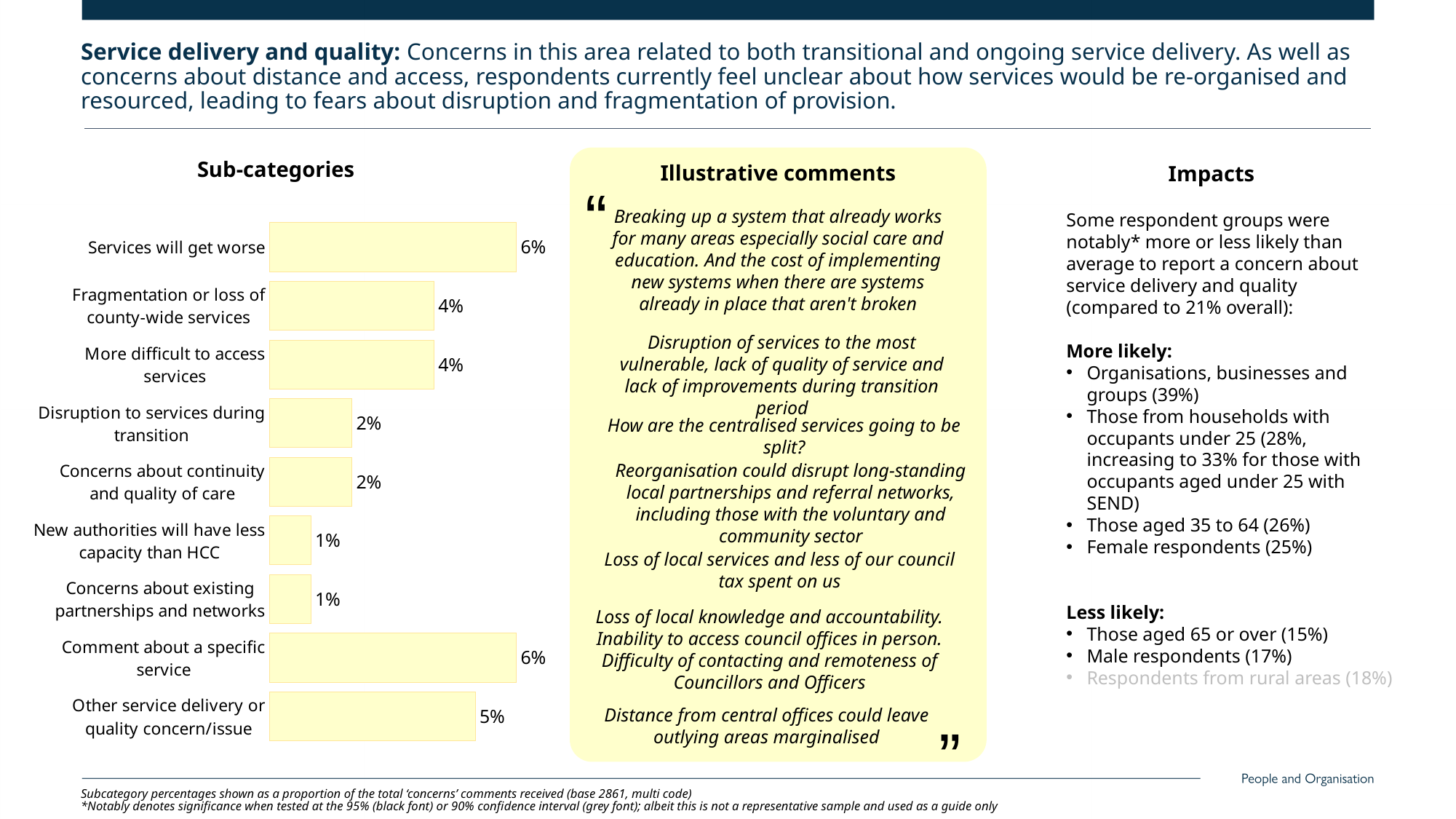
How many sub-categories are plotted in the Sub-categories chart? 9 What is the title of the chart on the slide? Sub-categories What percentage is shown for 'Services will get worse' in the Sub-categories chart? 6% What is the lowest percentage shown in the Sub-categories chart? 1% What value does the Sub-categories chart show for 'Other service delivery or quality concern/issue'? 5% What percentage is shown for 'More difficult to access services'? 4% What percentage is shown for 'Disruption to services during transition'? 2% What type of chart is used to show the Sub-categories? Bar chart What is the highest percentage shown in the Sub-categories chart? 6% What value is shown for 'New authorities will have less capacity than HCC'? 1% Which has the larger value: 'Other service delivery or quality concern/issue' or 'Fragmentation or loss of county-wide services'? Other service delivery or quality concern/issue What is the difference between the values for 'Services will get worse' and 'Fragmentation or loss of county-wide services'? 2%